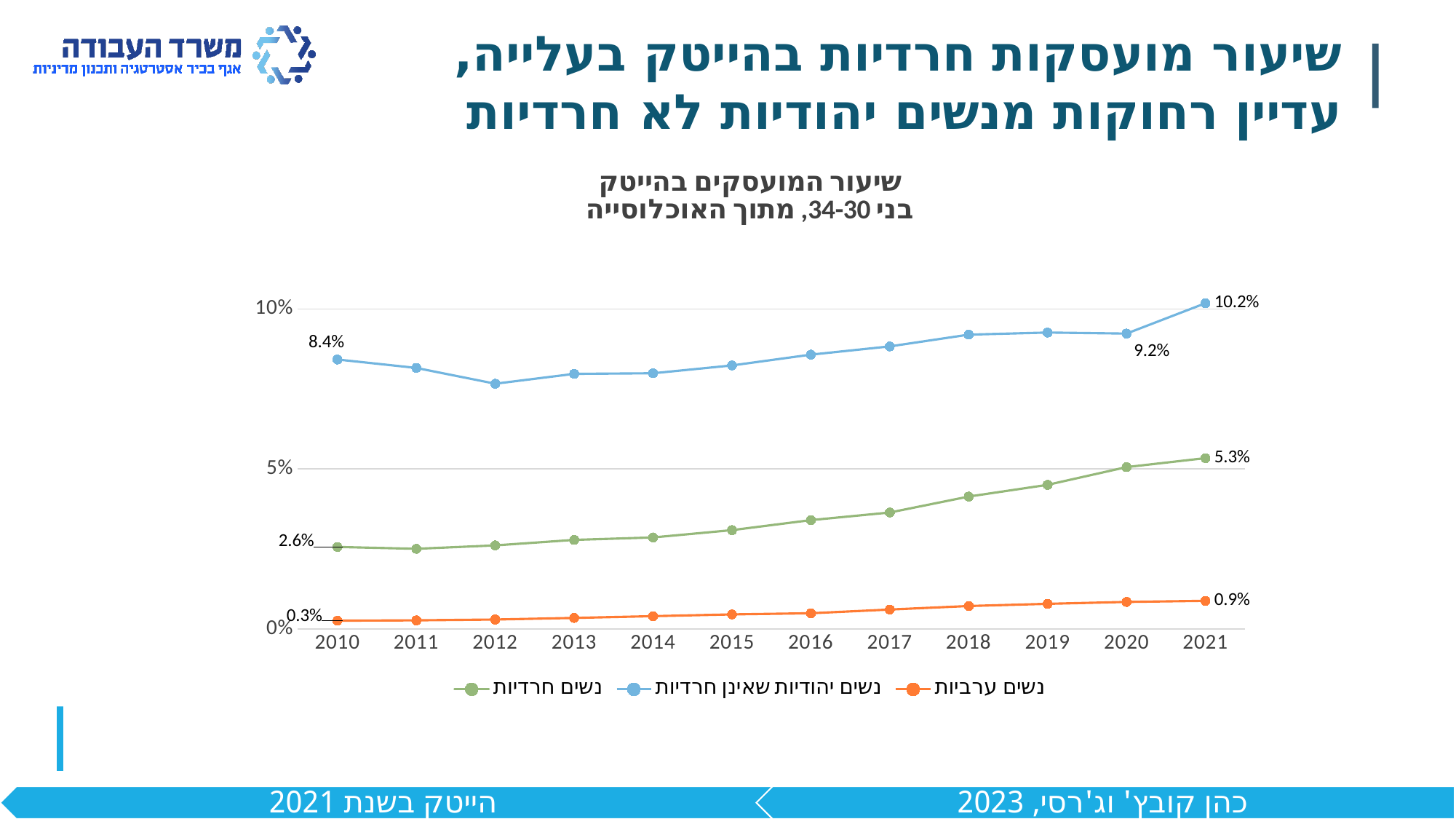
What is the difference between נשים יהודיות שאינן חרדיות and נשים חרדיות in 2021? 4.9% What is the value for נשים ערביות in 2021? 0.9% What is the value for נשים יהודיות שאינן חרדיות in 2021? 10.2% What is the value for נשים יהודיות שאינן חרדיות in 2020? 9.2% By how much did the value for נשים חרדיות change from 2010 to 2021? 2.7% What type of chart is shown on the slide? line chart How many years are shown on the x axis? 12 What is the value for נשים חרדיות in 2010? 2.6% Which series has the highest value in 2021? נשים יהודיות שאינן חרדיות Is the value for נשים חרדיות in 2018 greater or less than 5%? less Does the value for נשים חרדיות rise or fall from 2012 to 2021? rise How many series does the legend list? 3